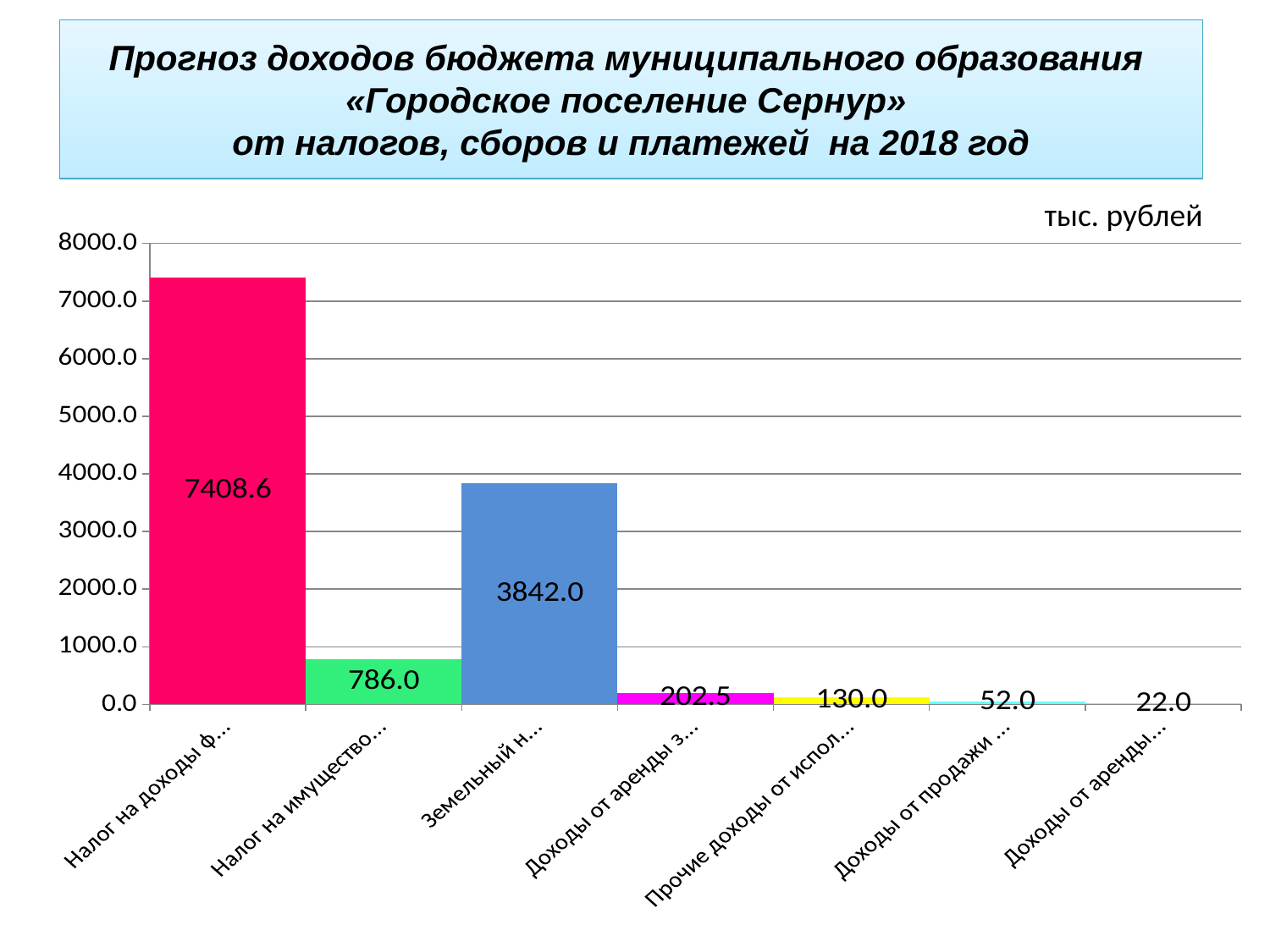
What is the value of the bar labelled "Земельный н…"? 3842.0 What is the value of the bar labelled "Налог на имущество…"? 786.0 Which is larger: the value for "Налог на имущество…" or the value for "Земельный н…"? Земельный н… How many bars (categories) are shown in the chart? 7 What is the value of the bar labelled "Доходы от продажи …"? 52.0 What unit is indicated above the chart? тыс. рублей What is the value of the bar labelled "Прочие доходы от испол…"? 130.0 Is the value for "Земельный н…" greater or less than 4000.0? less Which category has the highest value in the chart? Налог на доходы ф… (the first bar) What is the difference between the values for "Налог на доходы ф…" and "Земельный н…"? 3566.6 What is the value of the lowest bar in the chart (the rightmost one)? 22.0 What is the value of the bar labelled "Налог на доходы ф…" (the first bar)? 7408.6